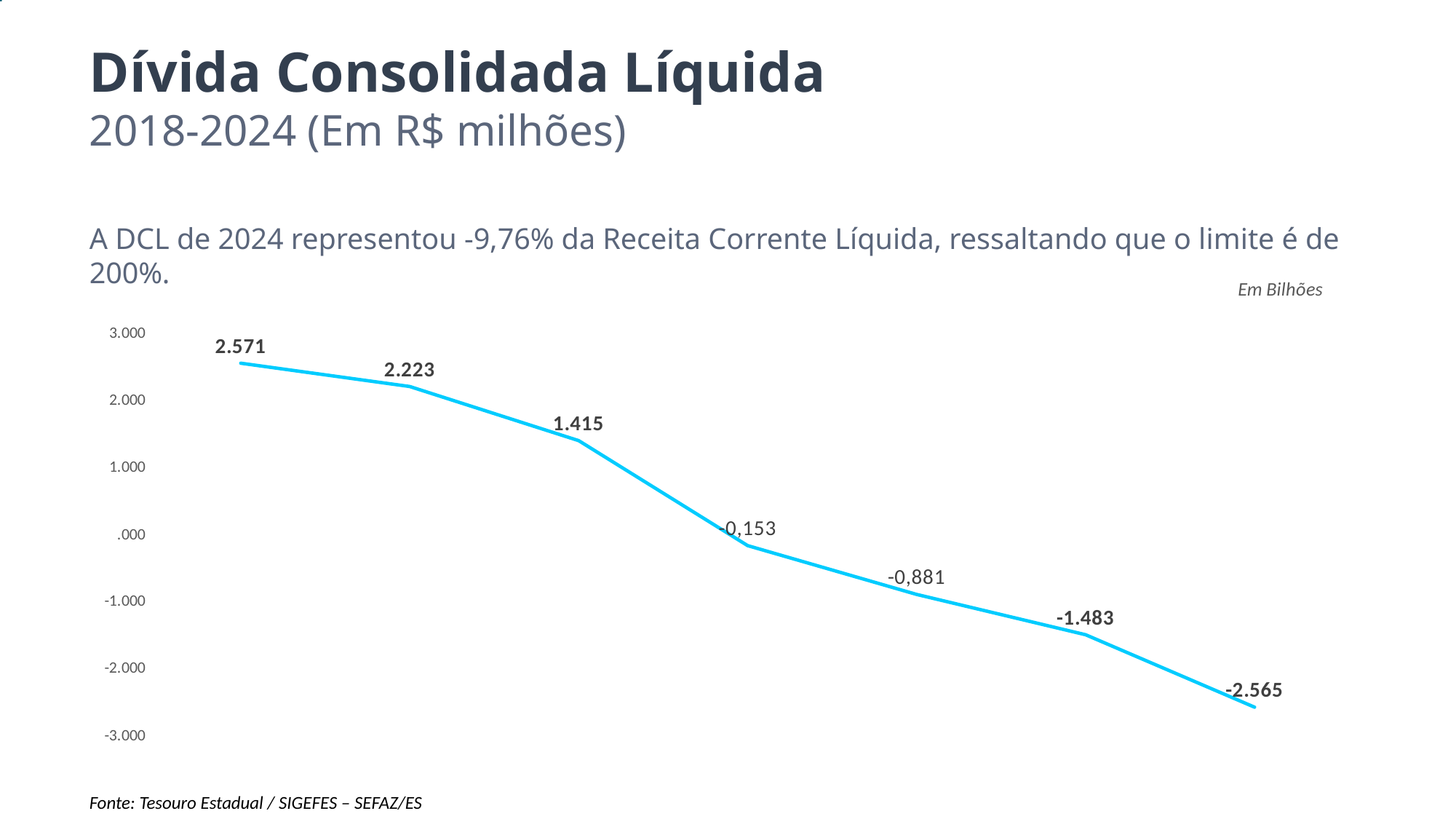
Which is larger, the second point (2.223) or the sixth point (-1.483)? 2.223 What is the lowest value plotted on the chart? -2.565 What kind of chart is shown on the slide? Line chart What is the value of the third point on the line? 1.415 What is the title of the chart on the slide? Em Bilhões What is the value of the first (leftmost) point on the line? 2.571 What is the value of the fifth point on the line? -0,881 What is the difference between the first point (2.571) and the third point (1.415)? 1.156 What is the highest value plotted on the chart? 2.571 How many data points are plotted on the line? 7 Do the values rise or fall from left to right along the line? Fall What is the value of the last (rightmost) point on the line? -2.565